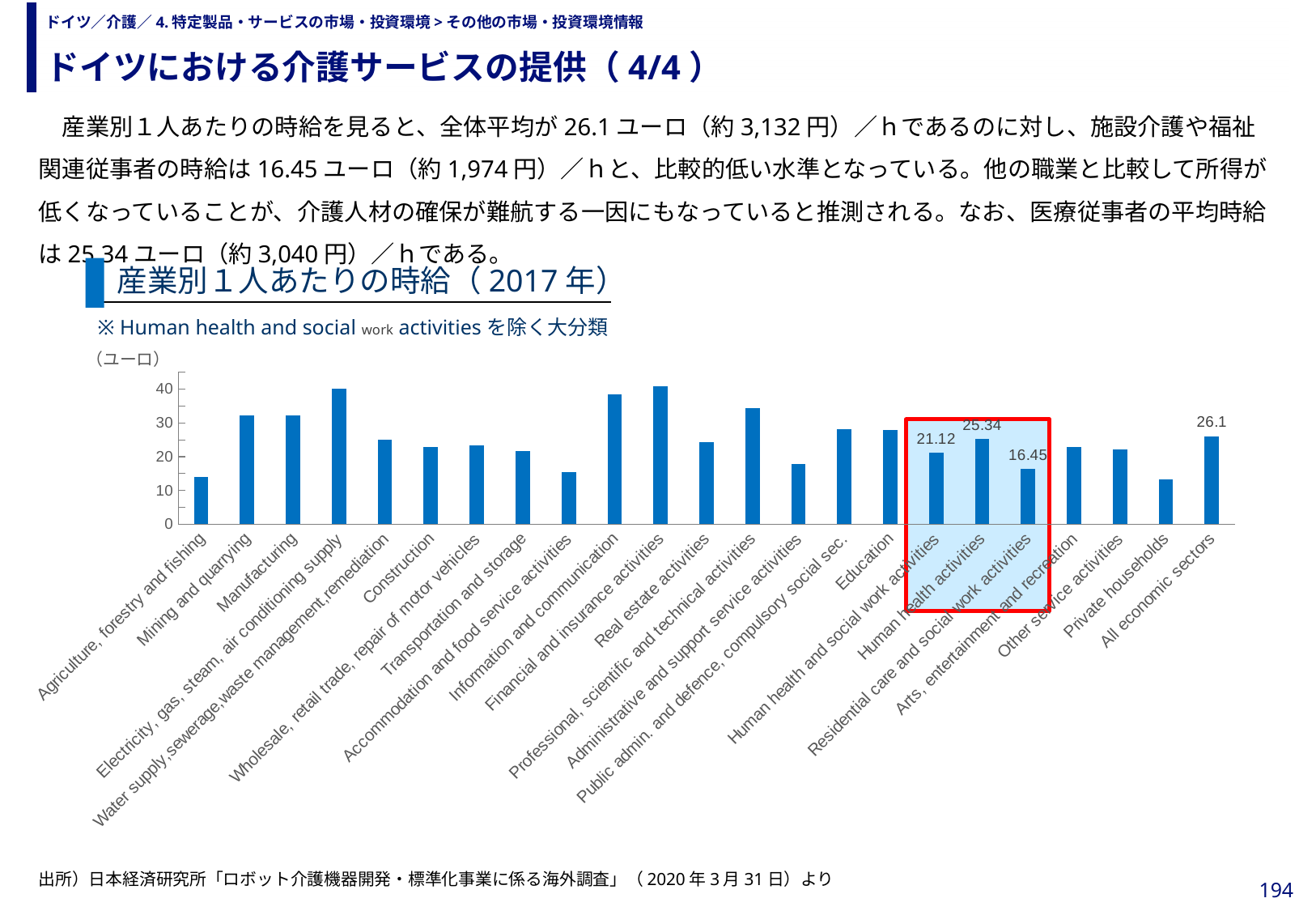
What is the difference between the values for Human health activities and Residential care and social work activities? 8.89 What kind of chart is shown on the slide? bar chart What is the hourly wage value shown for Residential care and social work activities? 16.45 Is the value for Electricity, gas, steam, air conditioning supply greater or less than 30? greater What is the hourly wage value shown for Human health activities? 25.34 What is the difference between the values for All economic sectors and Residential care and social work activities? 9.65 Is the value for Private households greater or less than 20? less What is the value shown for Human health and social work activities? 21.12 What is the value shown for All economic sectors? 26.1 Is the value for Accommodation and food service activities greater or less than 20? less Which is larger, the value for Human health activities or the value for Residential care and social work activities? Human health activities How many categories (bars) are shown in the chart? 23